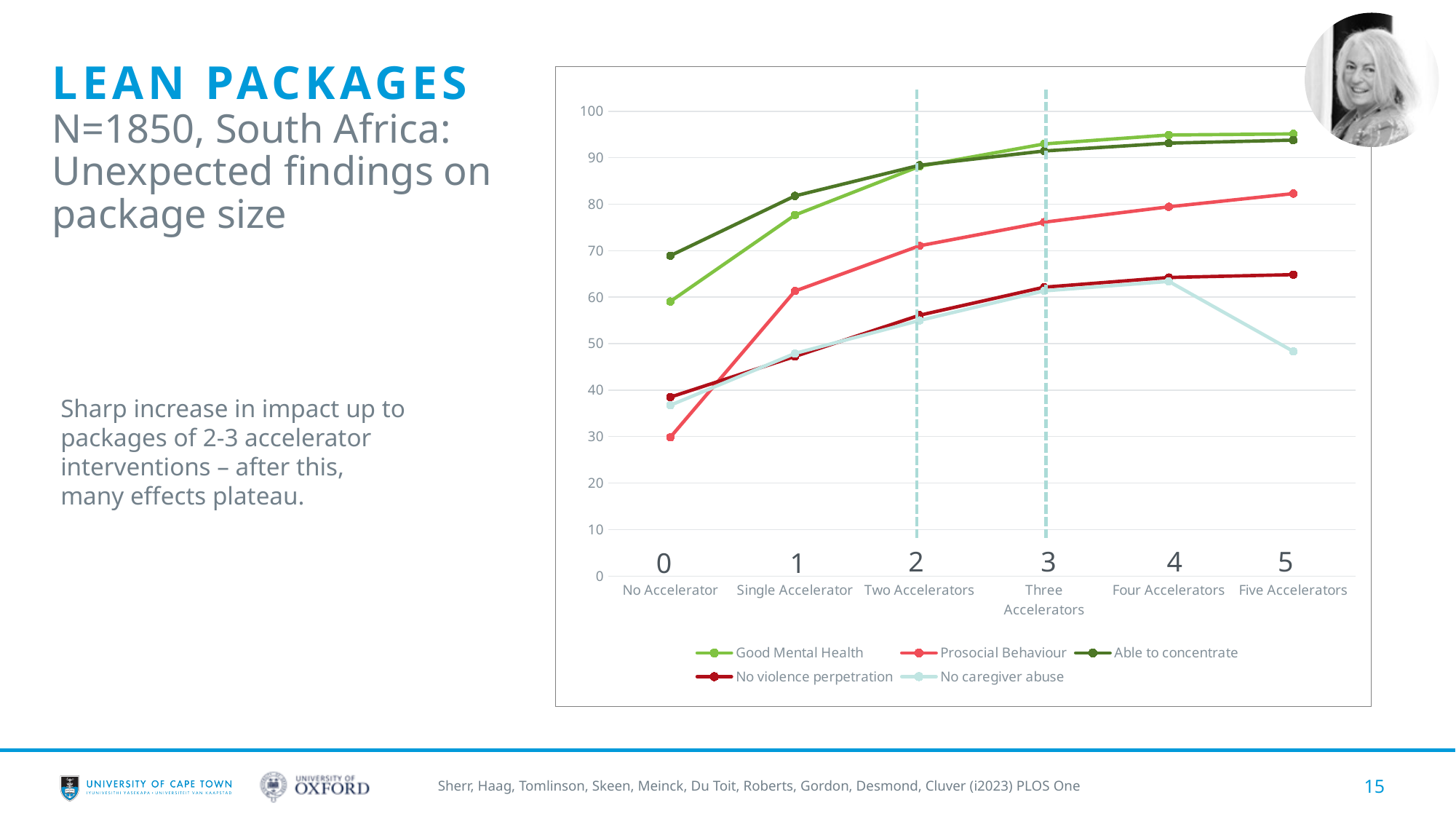
Which series has the highest value at No Accelerator? Able to concentrate Is the value for No caregiver abuse at Five Accelerators greater or less than 60? less At Five Accelerators, which is larger: No violence perpetration or No caregiver abuse? No violence perpetration How many series does the legend list? 5 How many categories are shown along the x axis? 6 What kind of chart is shown on the slide? line chart Does the Prosocial Behaviour line rise or fall from No Accelerator to Five Accelerators? rise At No Accelerator, which is larger: Able to concentrate or Good Mental Health? Able to concentrate Is the value for Prosocial Behaviour at No Accelerator greater or less than 40? less Is the value for Able to concentrate at Single Accelerator greater or less than 70? greater Which series has the lowest value at No Accelerator? Prosocial Behaviour